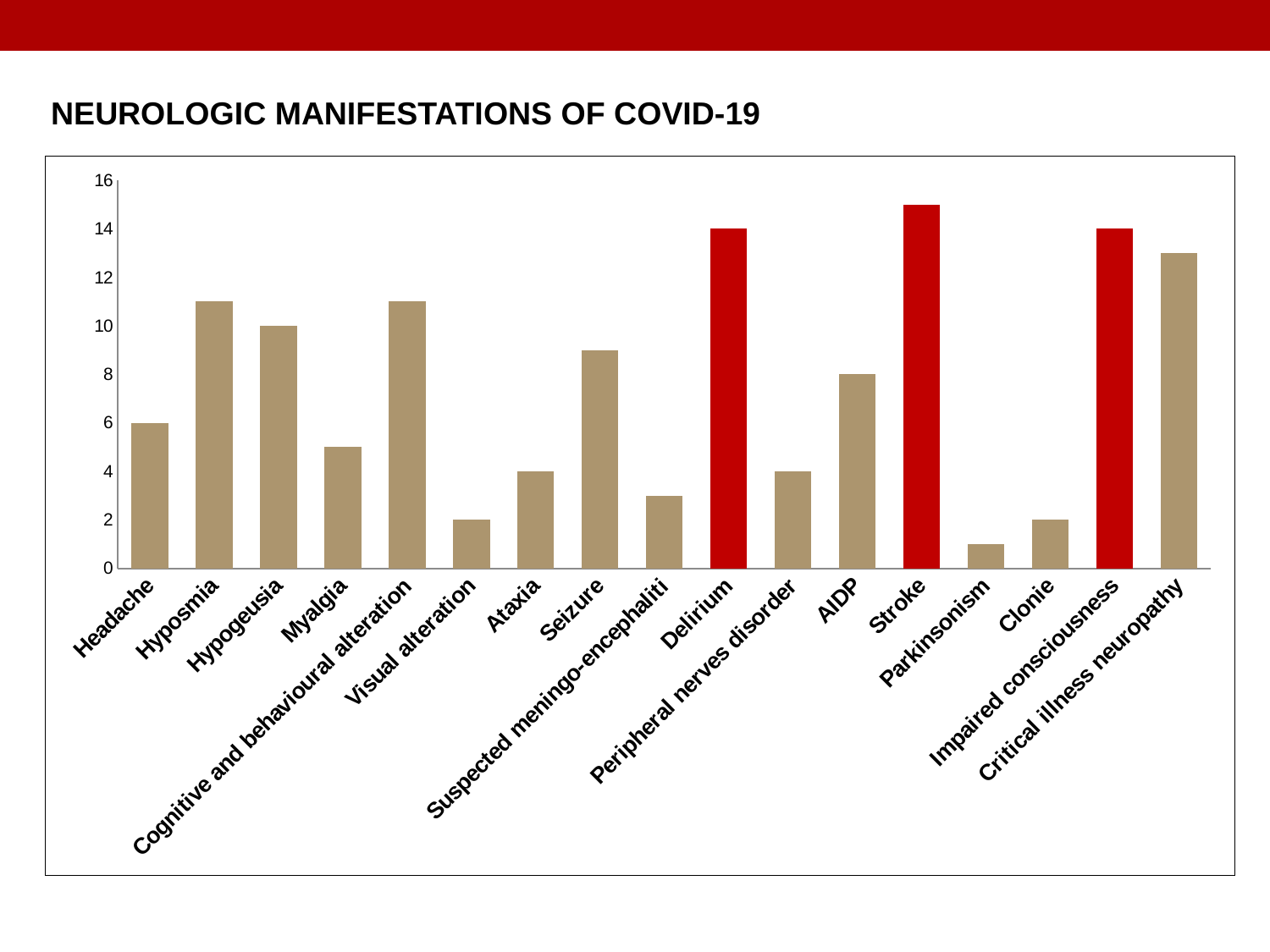
How many categories are shown on the x axis? 17 Is the value for Seizure greater or less than 10? less Which category has the highest value? Stroke What is the value for Headache? 6 Which is larger, the value for Headache or the value for Ataxia? Headache What kind of chart is shown on the slide? Bar chart What is the value for AIDP? 8 Is the value for Hyposmia greater or less than 10? greater Which category has the lowest value? Parkinsonism What is the value for Delirium? 14 What is the title of the chart? NEUROLOGIC MANIFESTATIONS OF COVID-19 What is the difference between the values for Headache and Visual alteration? 4